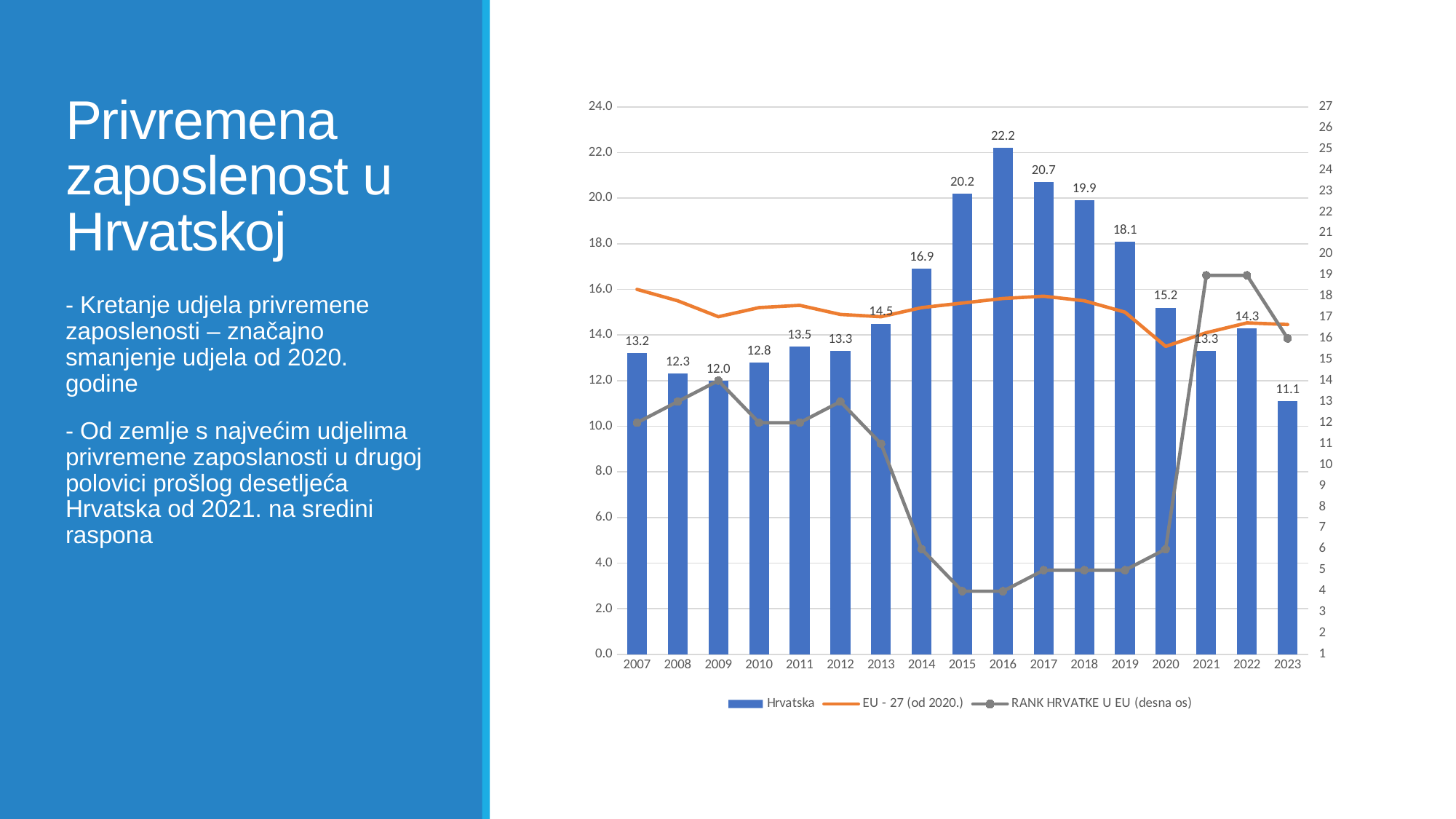
What kind of chart is shown on the slide? Combined bar and line chart What is the value of the Hrvatska bar for 2009? 12.0 Is the EU - 27 (od 2020.) value for 2020 greater or less than 14.0? less What is the difference between the Hrvatska values for 2016 and 2023? 11.1 Which is larger, the Hrvatska value for 2015 or for 2017? 2017 How many series does the legend list? 3 What is the value of the Hrvatska bar for 2016? 22.2 How many years are shown on the x axis? 17 Do the Hrvatska bar values rise or fall from 2016 to 2020? fall In which year is the Hrvatska bar highest? 2016 In which year is the Hrvatska bar lowest? 2023 What is the value of the Hrvatska bar for 2023? 11.1